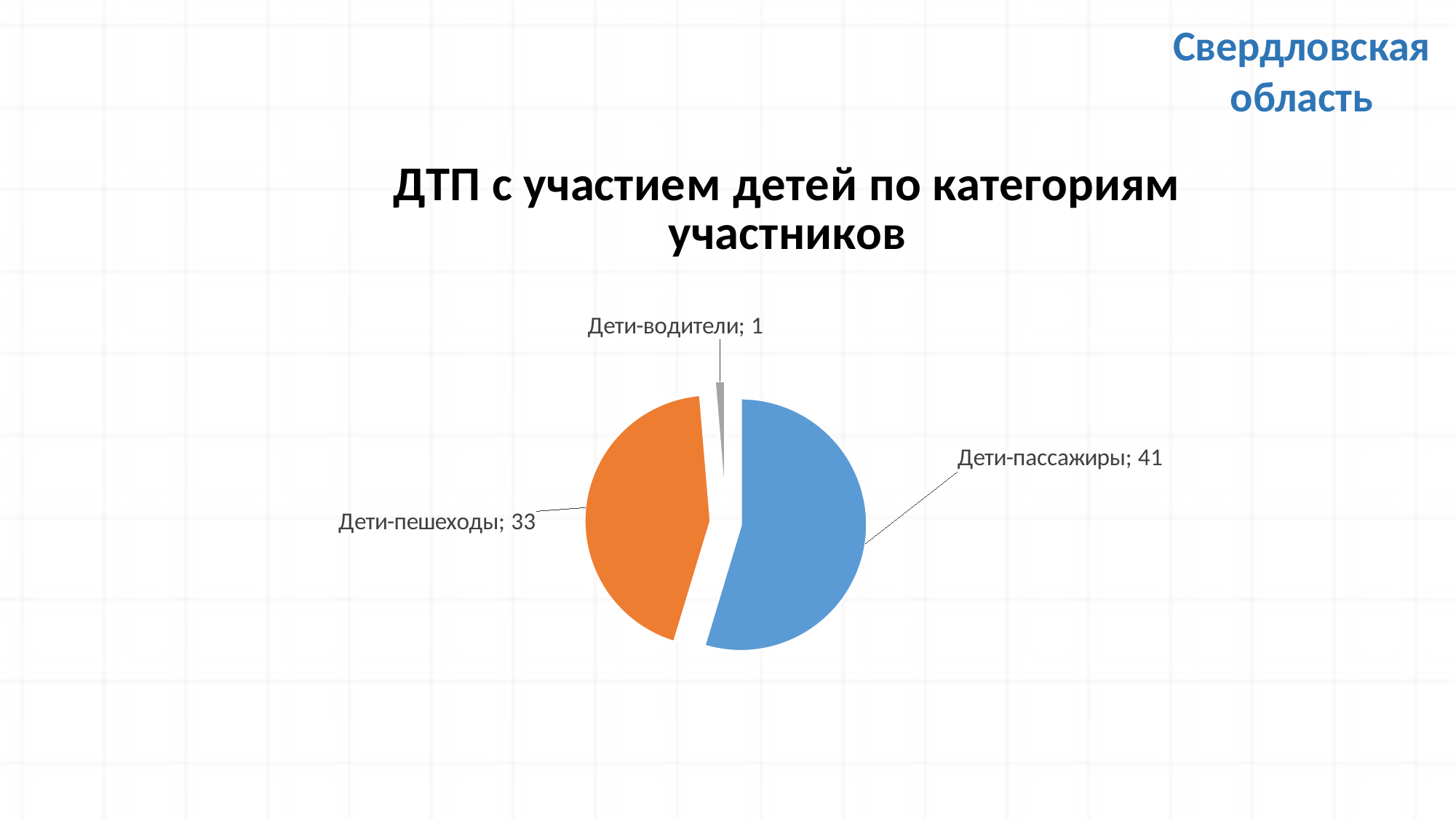
How many categories are shown in the pie chart? 3 What is the total of all the values in the pie chart? 75 Which category has the smallest slice of the pie? Дети-водители What is the value for Дети-водители? 1 What is the title of the chart? ДТП с участием детей по категориям участников What is the value for Дети-пассажиры? 41 What is the difference between the values for Дети-пассажиры and Дети-пешеходы? 8 What is the value for Дети-пешеходы? 33 Which is larger, the value for Дети-пассажиры or the value for Дети-пешеходы? Дети-пассажиры What type of chart is shown on the slide? pie chart Which category has the largest slice of the pie? Дети-пассажиры What is the difference between the values for Дети-пешеходы and Дети-водители? 32